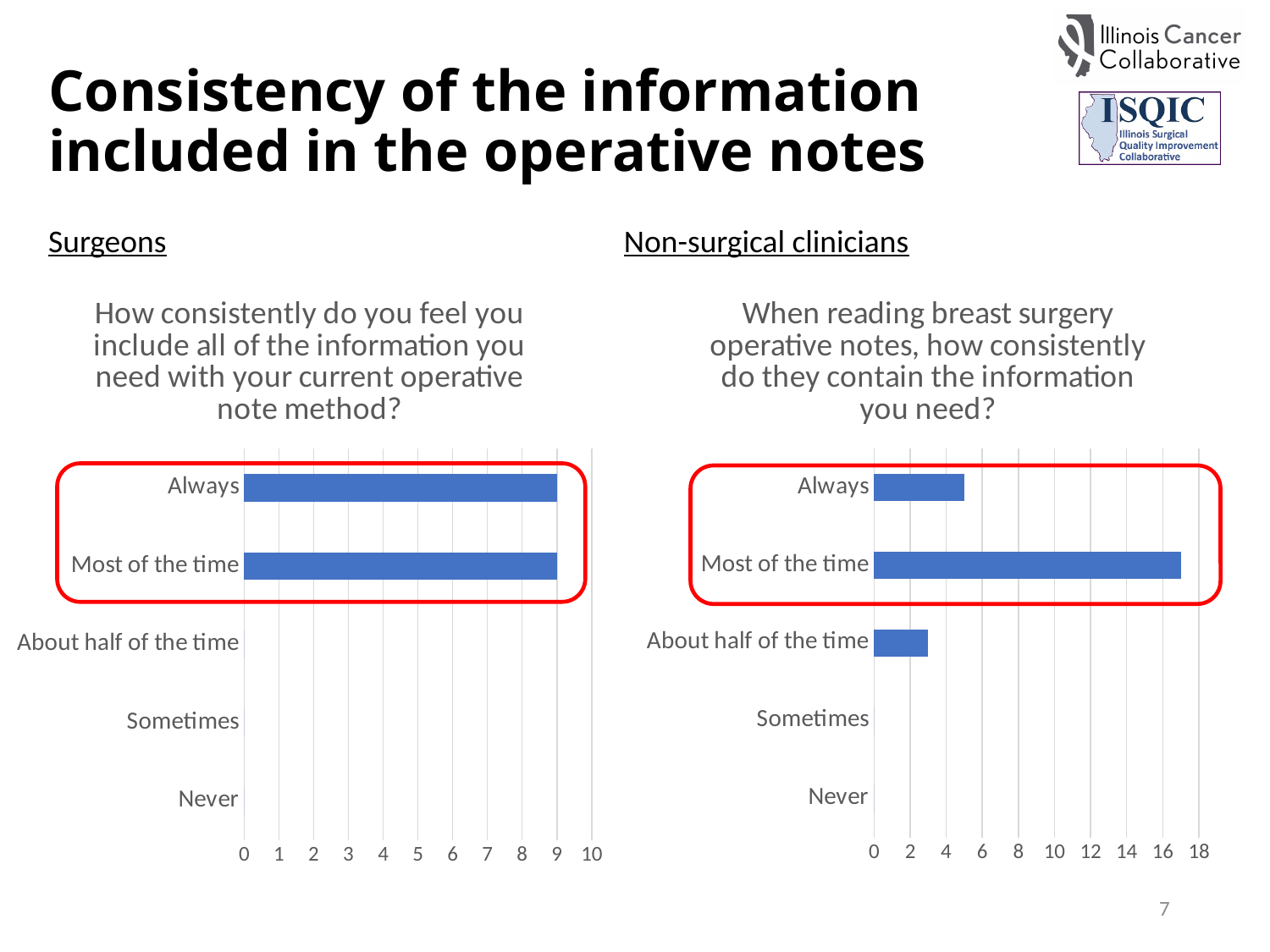
In the Non-surgical clinicians chart, which category has the highest value? Most of the time What kind of chart is the Non-surgical clinicians chart? bar chart What is the maximum value shown on the x axis of the Non-surgical clinicians chart? 18 What is the title of the Surgeons chart? How consistently do you feel you include all of the information you need with your current operative note method? In the Surgeons chart, what is the value for "Most of the time"? 9 In the Non-surgical clinicians chart, is the value for "About half of the time" greater or less than 4? less In the Non-surgical clinicians chart, is the value for "Most of the time" greater or less than 16? greater In the Non-surgical clinicians chart, is the value for "Always" greater or less than 4? greater In the Surgeons chart, what is the difference between the values for "Always" and "Most of the time"? 0 In the Surgeons chart, what is the value for "Always"? 9 How many categories are shown on the y axis of the Surgeons chart? 5 In the Non-surgical clinicians chart, which is larger, the value for "Always" or the value for "About half of the time"? Always